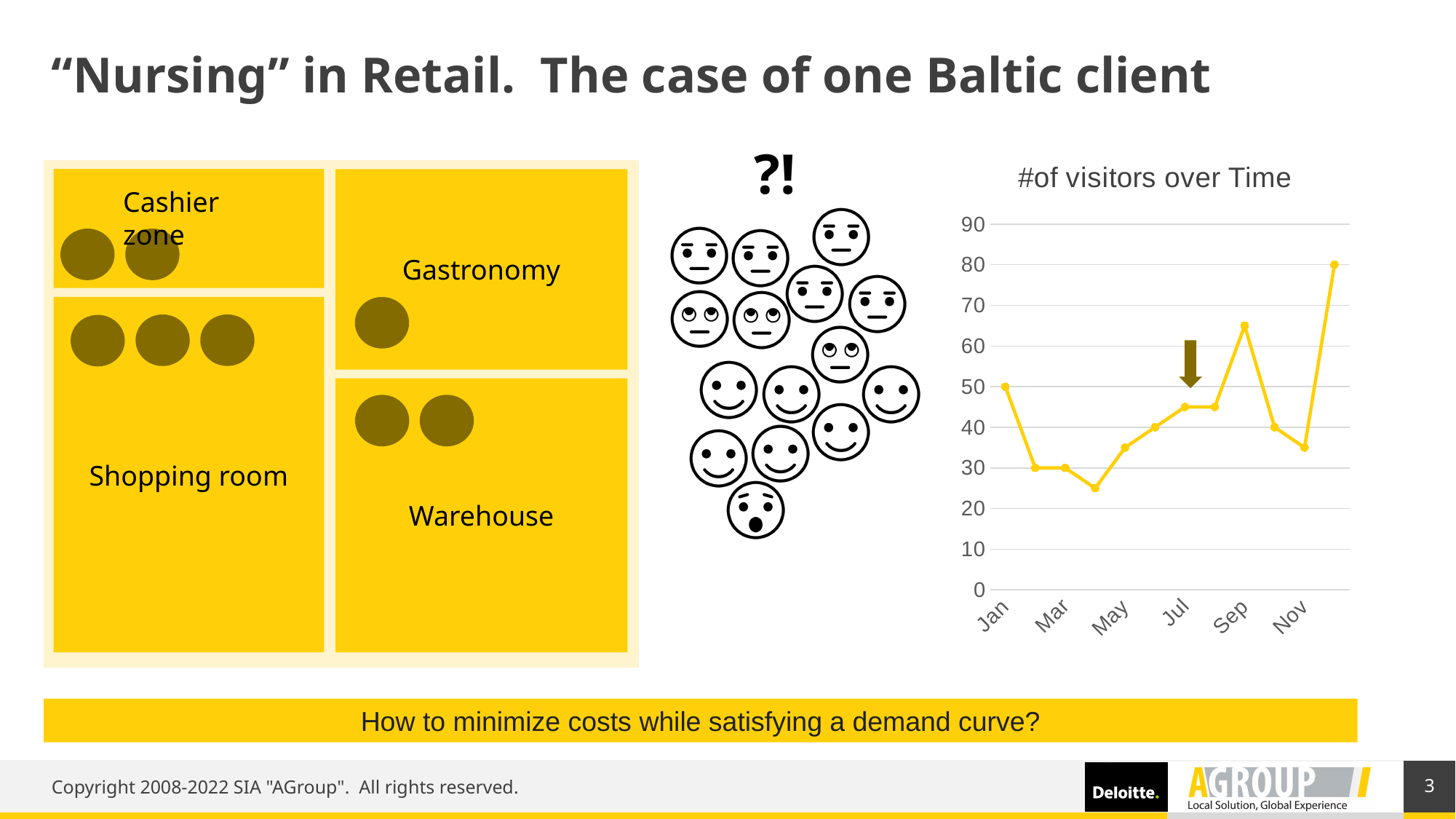
In the "#of visitors over Time" chart, is the value for Sep greater or less than 60? greater In the "#of visitors over Time" chart, is the value for Nov greater or less than 40? less In the "#of visitors over Time" chart, which is larger, the value for Sep or the value for Jul? Sep What is the title of the chart on the right of the slide? #of visitors over Time In the "#of visitors over Time" chart, what is the difference between the values for Jan and Mar? 20 How many data points are plotted in the "#of visitors over Time" chart? 12 In the "#of visitors over Time" chart, what is the value for Mar? 30 In the "#of visitors over Time" chart, do the values rise or fall from Mar to Jul? rise In the "#of visitors over Time" chart, is the value for Jul greater or less than 40? greater What kind of chart is the "#of visitors over Time" chart? line chart In the "#of visitors over Time" chart, which is larger, the value for Jan or the value for Mar? Jan In the "#of visitors over Time" chart, what is the value for Jan? 50